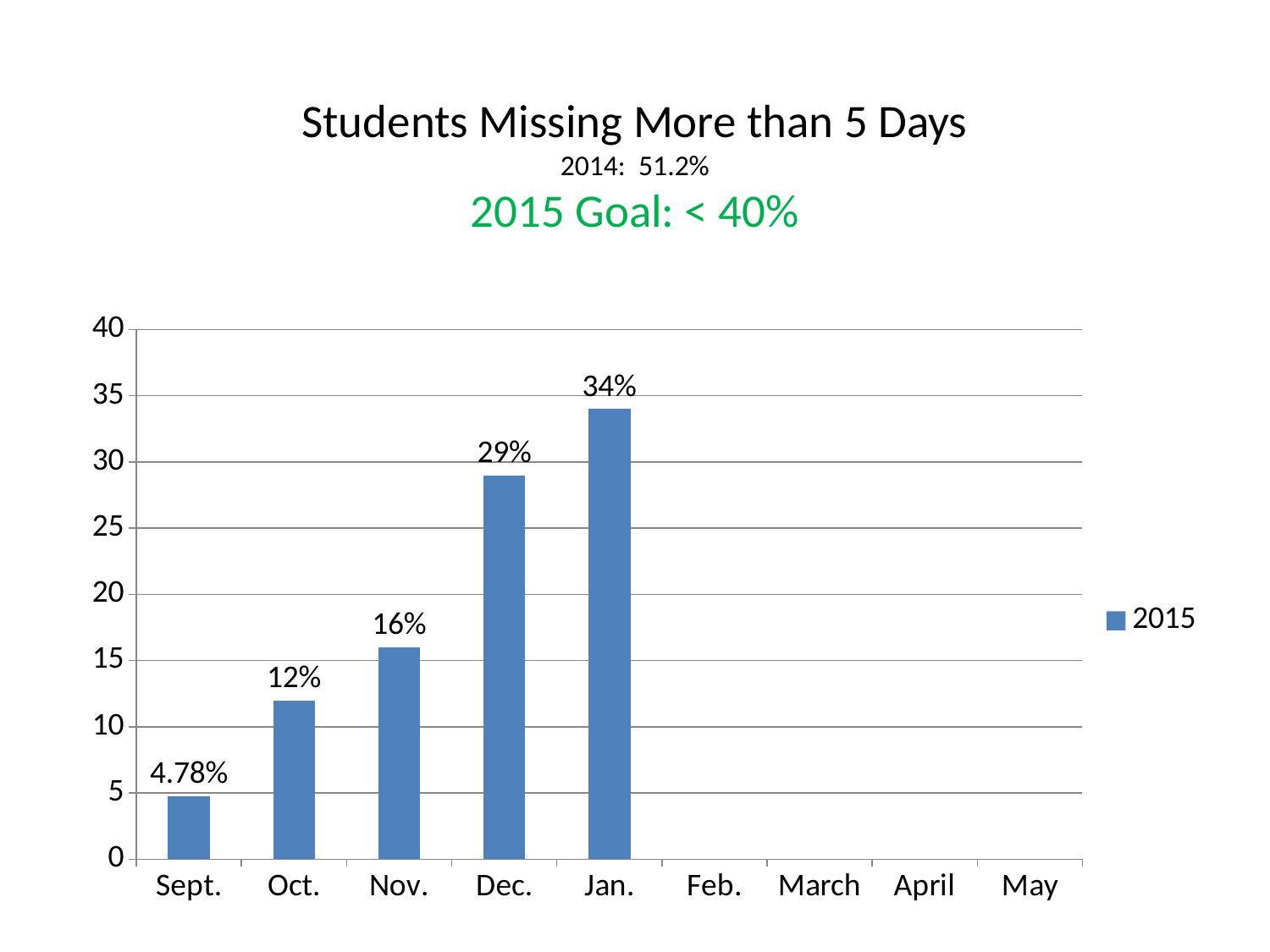
Which is larger, the value for Oct. or the value for Nov.? Nov. What kind of chart is shown on the slide? bar chart Do the values rise or fall from Sept. to Jan.? rise What is the value for Nov.? 16% How many series does the legend list? 1 Is the value for Jan. greater or less than 30? greater What is the difference between the values for Jan. and Dec.? 5% How many month categories are shown on the x axis? 9 What is the value for Dec.? 29% Which month has the highest value among the plotted bars? Jan. Which month has the lowest value among the plotted bars? Sept. What is the value for Sept.? 4.78%